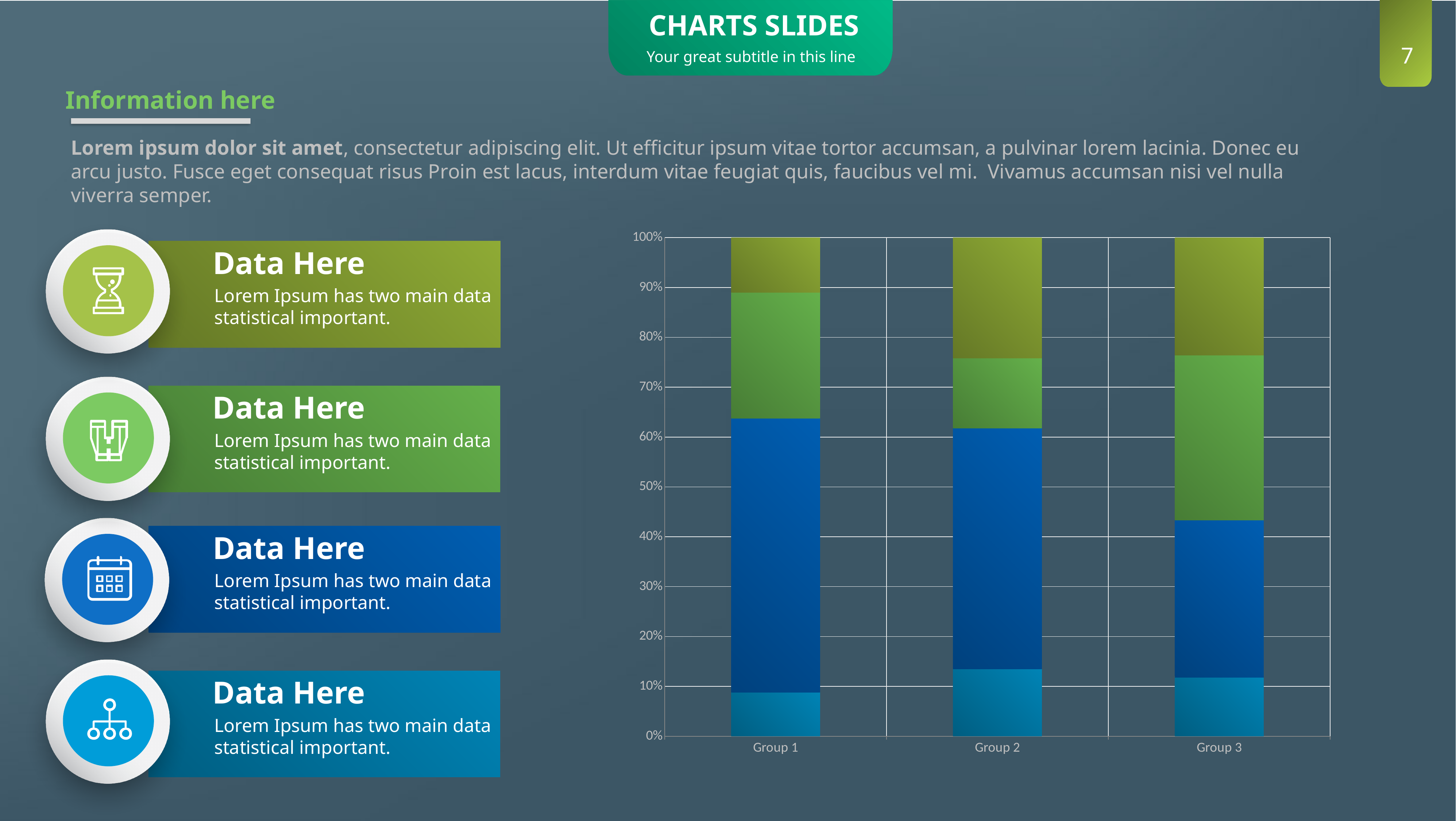
Is the top of the green segment in the Group 1 bar greater or less than 80%? greater What is the label of the rightmost bar on the x axis? Group 3 How many coloured segments make up each bar in the chart? 4 Which bar has the larger green segment, Group 2 or Group 3? Group 3 Is the top of the dark blue segment in the Group 1 bar greater or less than 60%? greater Which bar has the larger dark blue segment, Group 1 or Group 3? Group 1 Is the top of the dark blue segment in the Group 3 bar greater or less than 50%? less What is the total height of the Group 2 bar as read on the percentage axis? 100% What kind of chart is shown on the slide? Stacked bar chart How many groups (categories) are shown on the x axis of the chart? 3